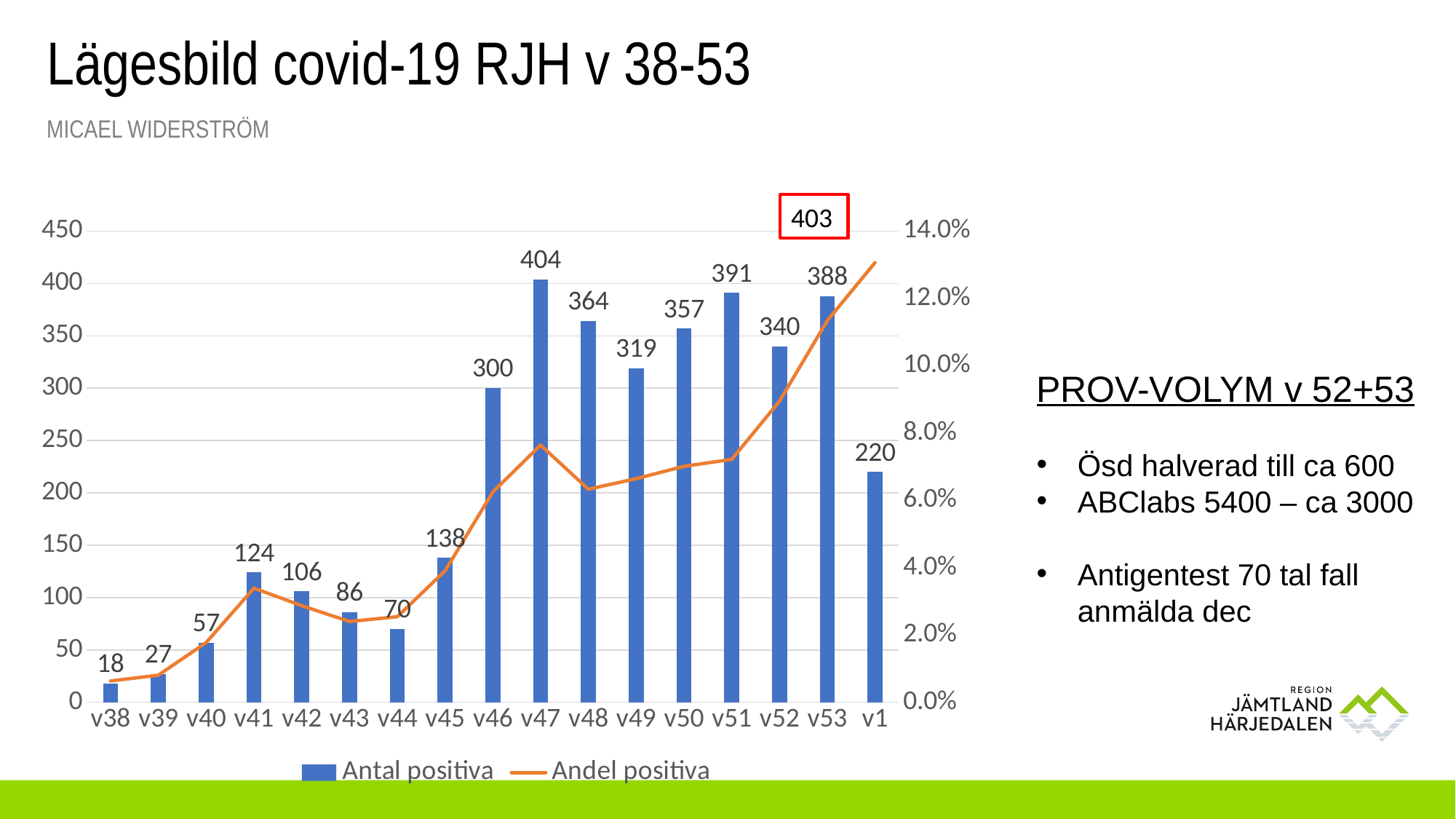
Which week has the highest Antal positiva? v47 What kind of chart is used to show Antal positiva? bar chart How many series does the chart legend list? 2 What is the value of Antal positiva for v41? 124 Is the Andel positiva value for v1 greater or less than 12.0%? greater What is the value of Antal positiva for v1? 220 What is the value of Antal positiva for v47? 404 How many weeks are shown on the x axis of the chart? 17 What is the difference in Antal positiva between v53 and v52? 48 Is the Andel positiva value for v38 greater or less than 2.0%? less Which week has a larger Antal positiva, v50 or v49? v50 Which week has the lowest Antal positiva? v38